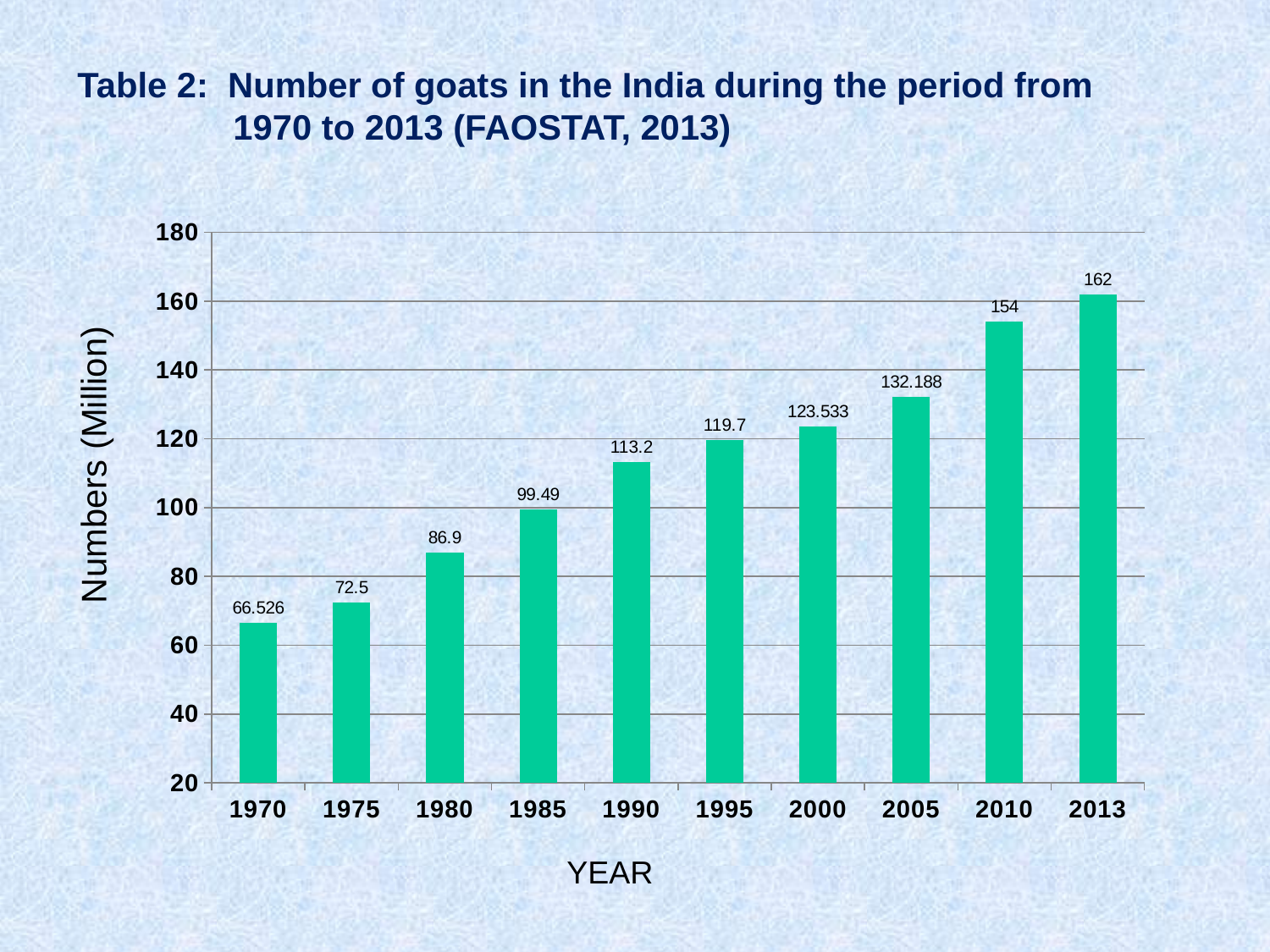
What kind of chart is shown on the slide? Bar chart Which year has the highest number of goats? 2013 Is the value for 2010 greater or less than 140? greater Do the values rise or fall from 1970 to 2013? Rise Which is larger, the value for 1995 or the value for 2000? 2000 Which year has the lowest number of goats? 1970 What is the number of goats (in million) in India in 1990? 113.2 What is the value shown for 2005? 132.188 How many years are shown on the x axis? 10 What is the difference between the values for 1985 and 1980? 12.59 What is the difference between the values for 2013 and 2010? 8 What is the value shown for 1970? 66.526